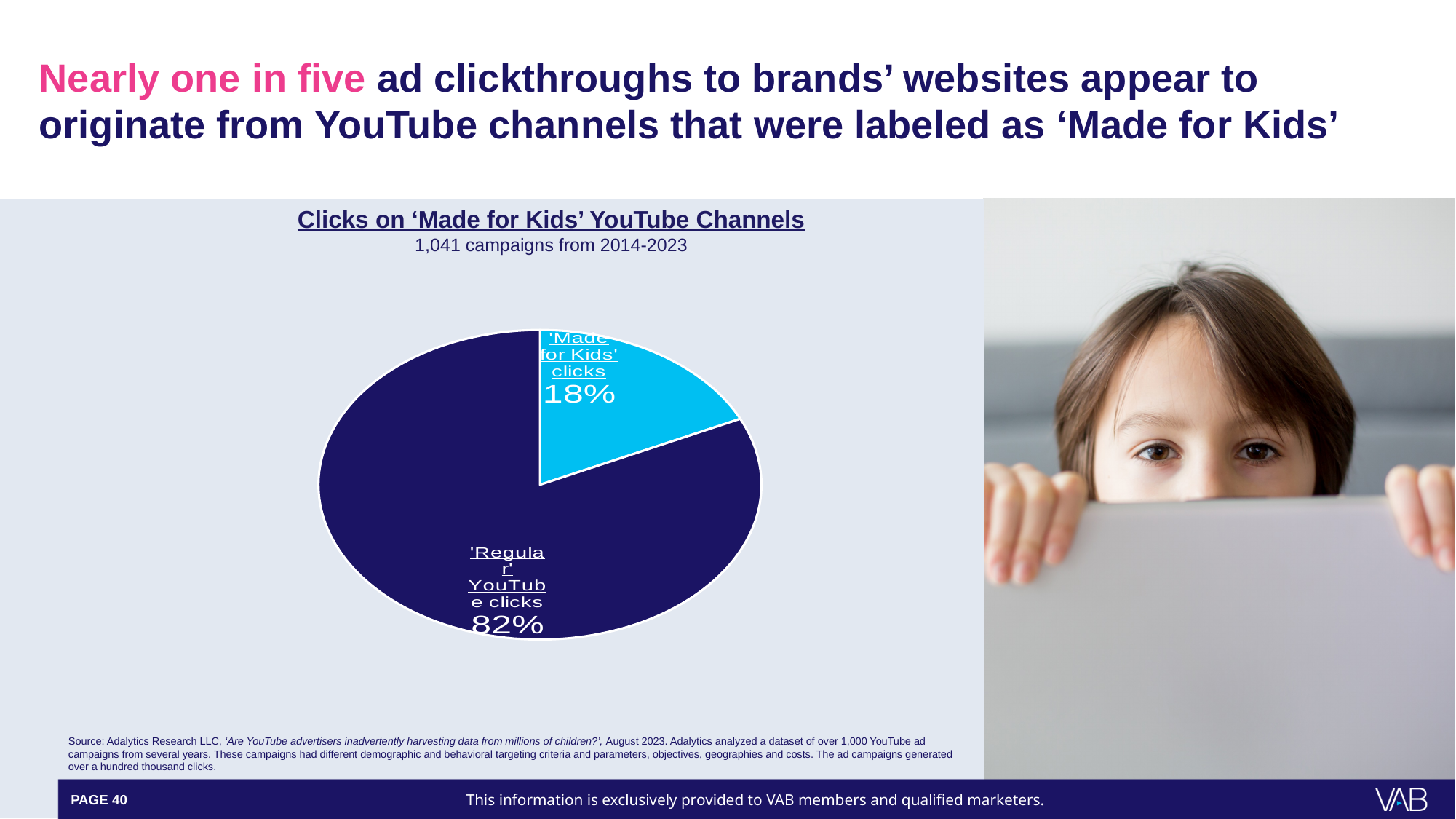
Which is larger: 'Made for Kids' clicks or 'Regular' YouTube clicks? 'Regular' YouTube clicks How many slices does the pie chart have? 2 What is the title of the chart? Clicks on 'Made for Kids' YouTube Channels Which slice of the pie is the smallest? 'Made for Kids' clicks What is the difference in percentage points between 'Regular' YouTube clicks and 'Made for Kids' clicks? 64 percentage points Which slice of the pie is the largest? 'Regular' YouTube clicks How many campaigns does the chart subtitle say were analyzed? 1,041 campaigns from 2014-2023 What share of clicks comes from 'Made for Kids' clicks? 18% What share of clicks comes from 'Regular' YouTube clicks? 82% What kind of chart is shown on the slide? Pie chart What is the combined share of the two slices in the pie chart? 100%